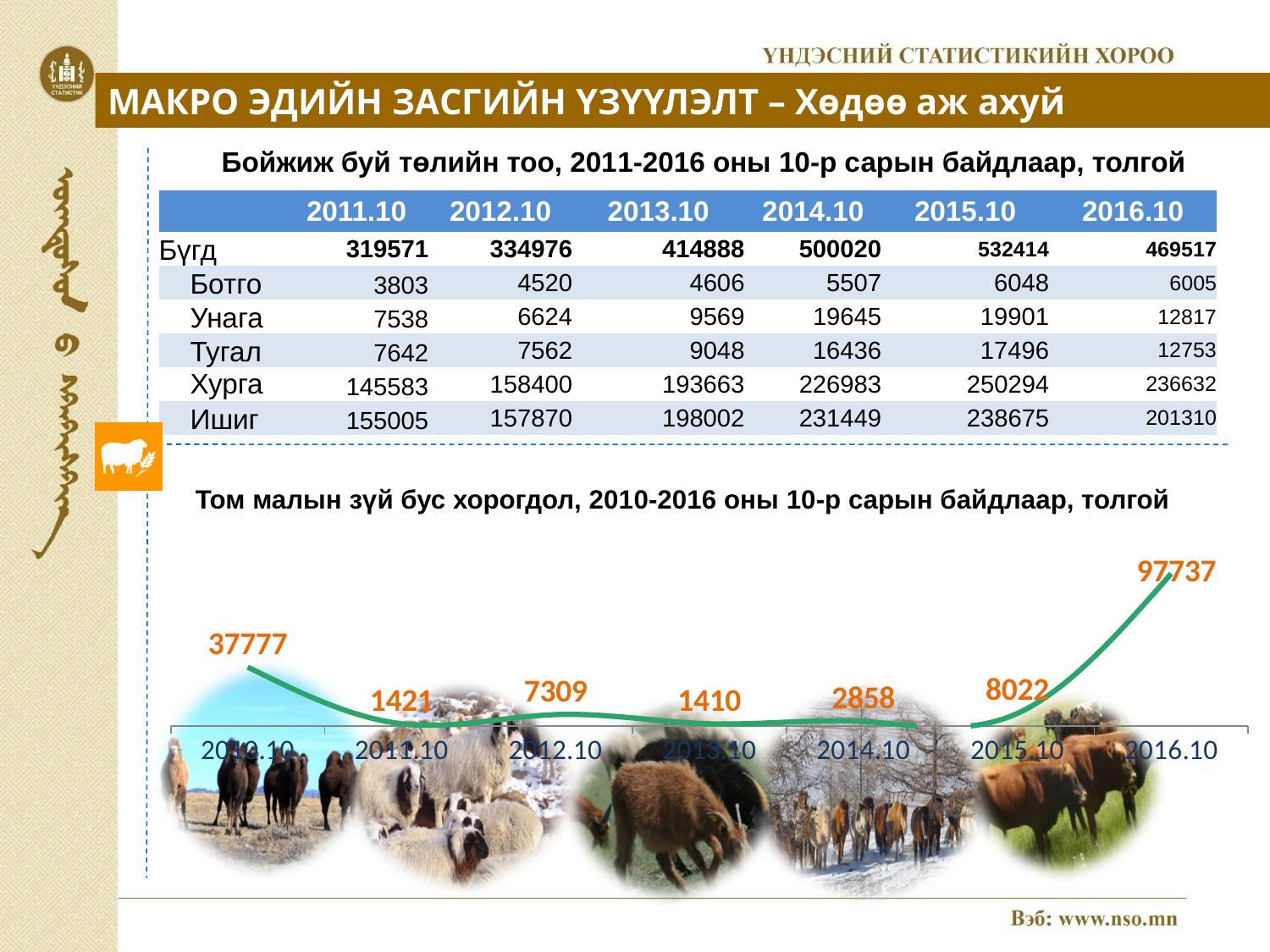
In the line chart 'Том малын зүй бус хорогдол', which year has the lowest value? 2013.10 In the line chart 'Том малын зүй бус хорогдол', what is the difference between the values for 2016.10 and 2015.10? 89715 In the line chart 'Том малын зүй бус хорогдол', does the value rise or fall from 2014.10 to 2016.10? Rise In the line chart 'Том малын зүй бус хорогдол', which year has the highest value? 2016.10 In the line chart 'Том малын зүй бус хорогдол', what is the value for 2010.10? 37777 In the line chart 'Том малын зүй бус хорогдол', what is the value for 2013.10? 1410 In the line chart 'Том малын зүй бус хорогдол', what is the value for 2016.10? 97737 How many data points are plotted in the line chart 'Том малын зүй бус хорогдол'? 7 What type of chart is 'Том малын зүй бус хорогдол, 2010-2016 оны 10-р сарын байдлаар, толгой'? Line chart In the line chart 'Том малын зүй бус хорогдол', which is larger, the value for 2014.10 or the value for 2012.10? 2012.10 In the line chart 'Том малын зүй бус хорогдол', what is the value for 2015.10? 8022 In the line chart 'Том малын зүй бус хорогдол', what is the difference between the values for 2012.10 and 2011.10? 5888